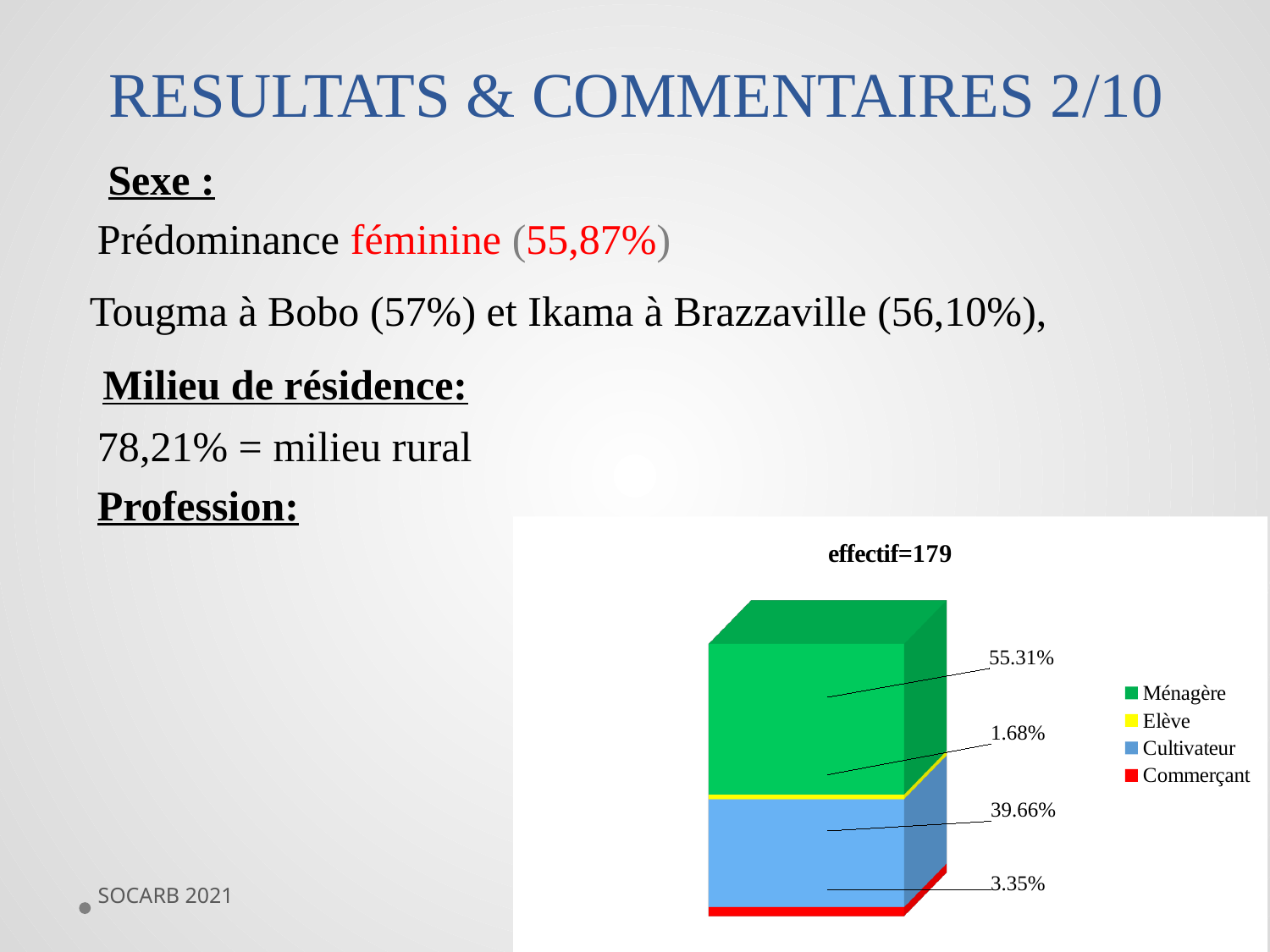
What is the value for Commerçant in the chart? 3.35% What is the title of the chart? effectif=179 What is the value for Cultivateur in the chart? 39.66% Which is larger, the value for Commerçant or the value for Elève? Commerçant What is the value for Ménagère in the chart? 55.31% How many series does the chart legend list? 4 What is the value for Elève in the chart? 1.68% Which profession has the lowest share in the chart? Elève What is the difference between the values for Ménagère and Cultivateur? 15.65% Which profession has the highest share in the chart? Ménagère What type of chart is shown on the slide? stacked bar chart Which colour represents Cultivateur in the chart legend? blue